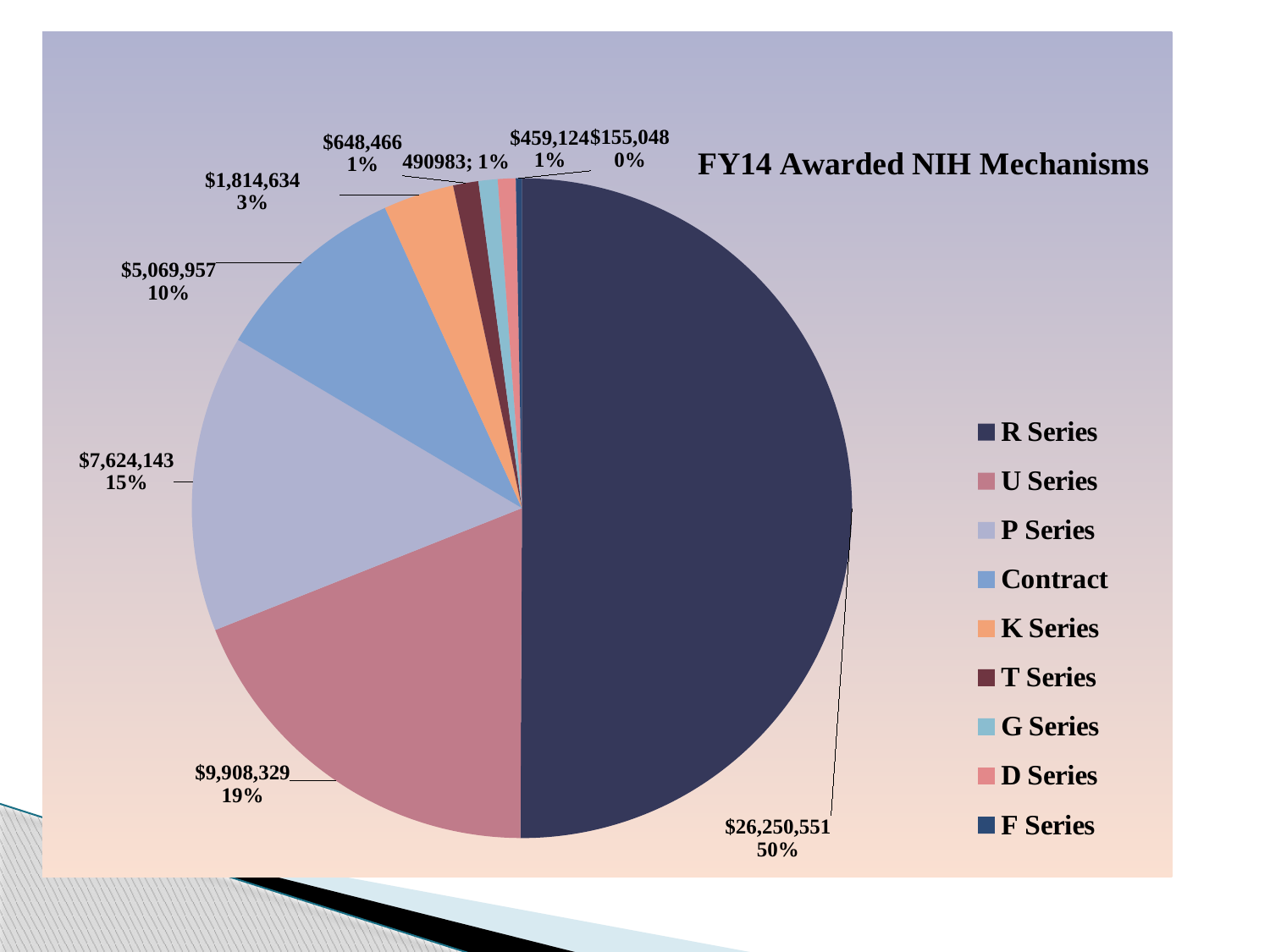
What is the value shown for R Series? $26,250,551 What is the value shown for K Series? $1,814,634 What type of chart is shown on the slide? pie chart Which category has the smallest slice of the pie? F Series What is the value shown for Contract? $5,069,957 What is the value shown for U Series? $9,908,329 What is the title of the chart? FY14 Awarded NIH Mechanisms Which is larger, the value for Contract or the value for K Series? Contract Which category has the largest slice of the pie? R Series How many entries does the legend list? 9 What share of the pie does P Series represent? 15% What is the difference between the values for U Series and P Series? $2,284,186